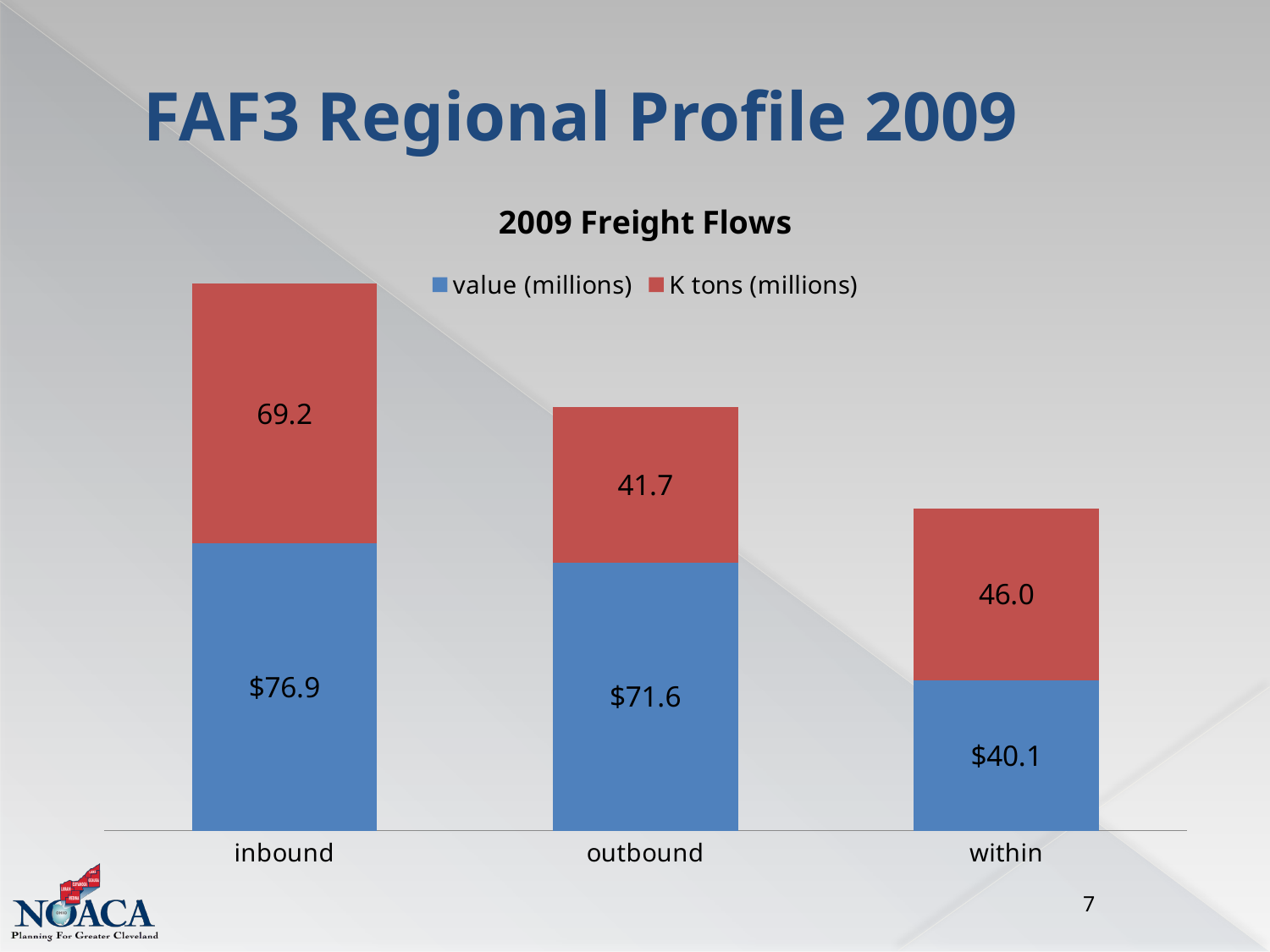
What is the difference in K tons (millions) between inbound and outbound? 27.5 What is the K tons (millions) figure for within? 46.0 What kind of chart is shown on the slide? stacked bar chart Which category has the lowest value (millions)? within Which category has the lowest K tons (millions)? outbound Which category has the highest K tons (millions)? inbound What is the K tons (millions) figure for outbound? 41.7 How many series does the legend list? 2 What is the difference in value (millions) between inbound and within? $36.8 What is the value (millions) for inbound? $76.9 How many categories are shown on the x axis? 3 Which has the larger K tons (millions) figure, outbound or within? within